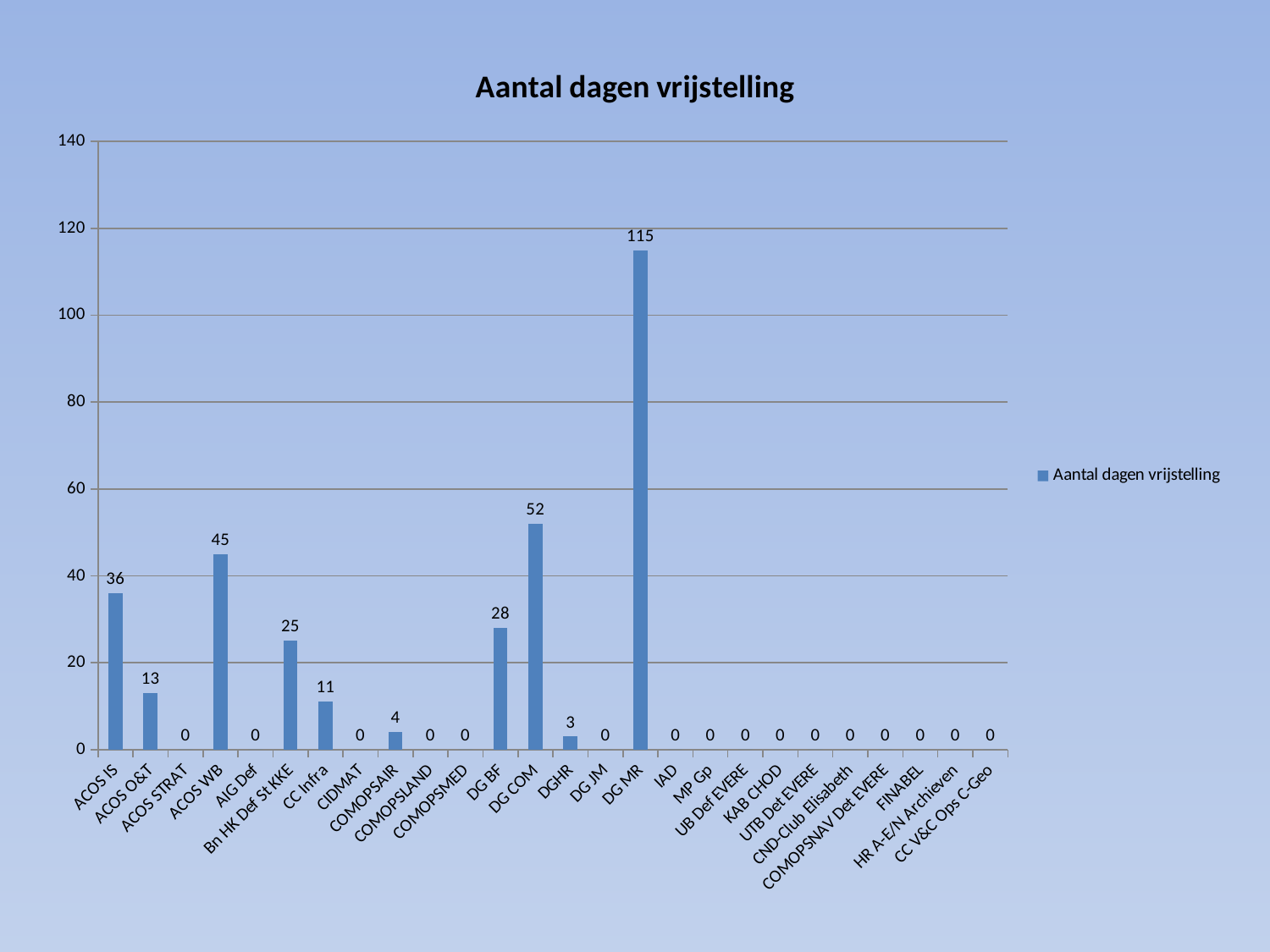
Which category has the highest value? DG MR How many series does the legend list? 1 What is the value for Bn HK Def St KKE? 25 What is the value for ACOS WB? 45 What kind of chart is shown? bar chart What is the difference between the values for DG COM and DG BF? 24 Which is larger, the value for CC Infra or the value for DGHR? CC Infra What is the difference between the values for ACOS IS and ACOS O&T? 23 What is the value for DG MR? 115 What is the title of the chart? Aantal dagen vrijstelling Is the value for DG MR greater or less than 100? greater What is the value for COMOPSAIR? 4